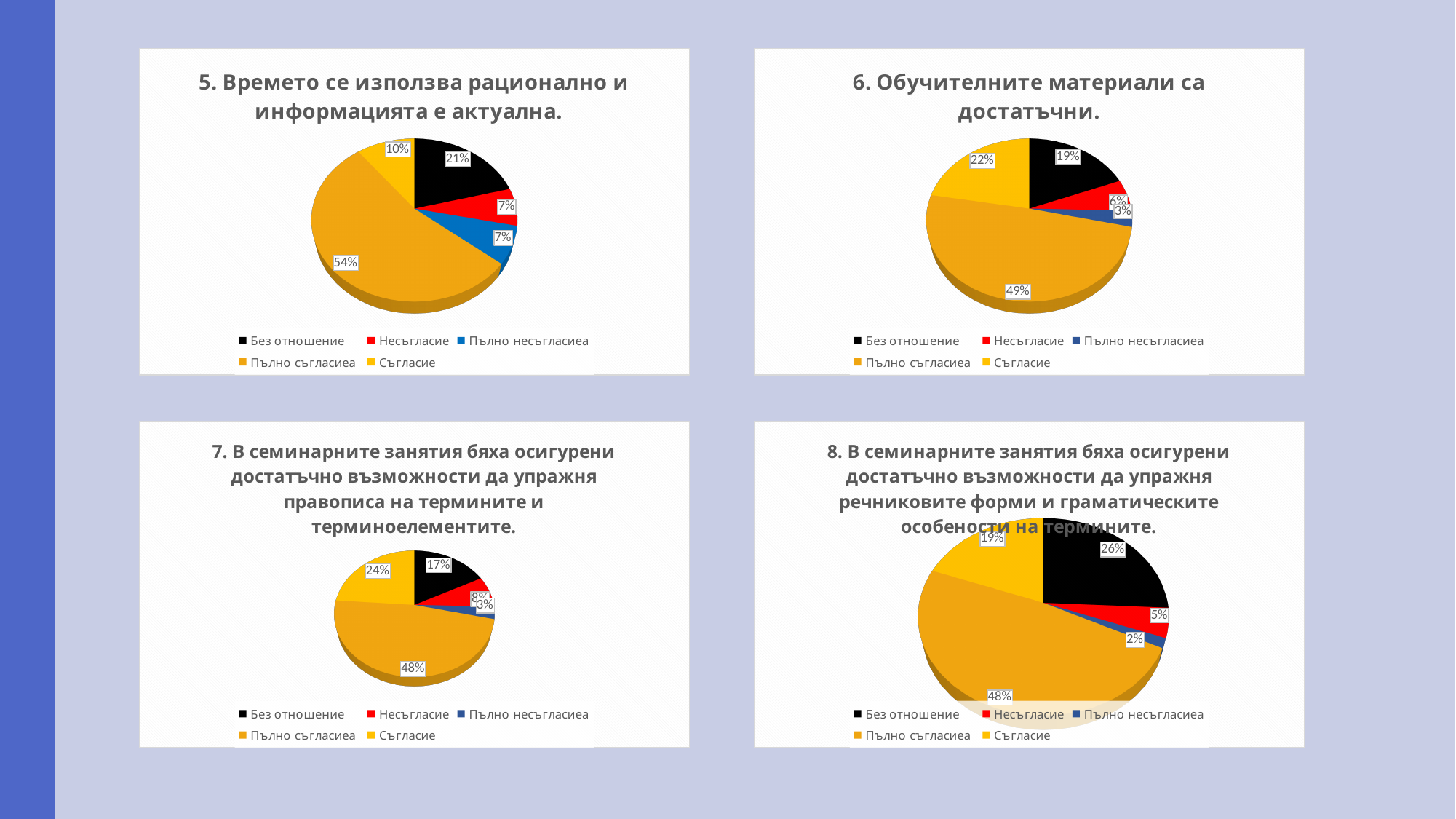
In the bottom-left chart (7. В семинарните занятия...правописа на термините и терминоелементите.), what percentage is shown for Несъгласие? 8% In the bottom-left chart (7. В семинарните занятия...правописа на термините и терминоелементите.), which category has the largest slice? Пълно съгласиеа In the top-left chart (5. Времето се използва рационално и информацията е актуална.), what percentage is shown for Пълно съгласиеа? 54% In the top-right chart (6. Обучителните материали са достатъчни.), what colour is the slice for Съгласие? Yellow In the top-right chart (6. Обучителните материали са достатъчни.), what percentage is shown for Съгласие? 22% In the top-left chart (5. Времето се използва рационално и информацията е актуална.), which is larger: Без отношение or Съгласие? Без отношение In the top-right chart (6. Обучителните материали са достатъчни.), which category has the smallest slice? Пълно несъгласиеа In the bottom-right chart (8. В семинарните занятия...речниковите форми и граматическите особености на термините.), what percentage is shown for Без отношение? 26% How many categories does the legend of the top-right chart (6. Обучителните материали са достатъчни.) list? 5 In the top-left chart (5. Времето се използва рационално и информацията е актуална.), what percentage is shown for Без отношение? 21% In the bottom-right chart (8. В семинарните занятия...речниковите форми и граматическите особености на термините.), what is the difference in percentage points between Пълно съгласиеа and Съгласие? 29 What type of chart is the bottom-left chart (7. В семинарните занятия...правописа на термините и терминоелементите.)? Pie chart